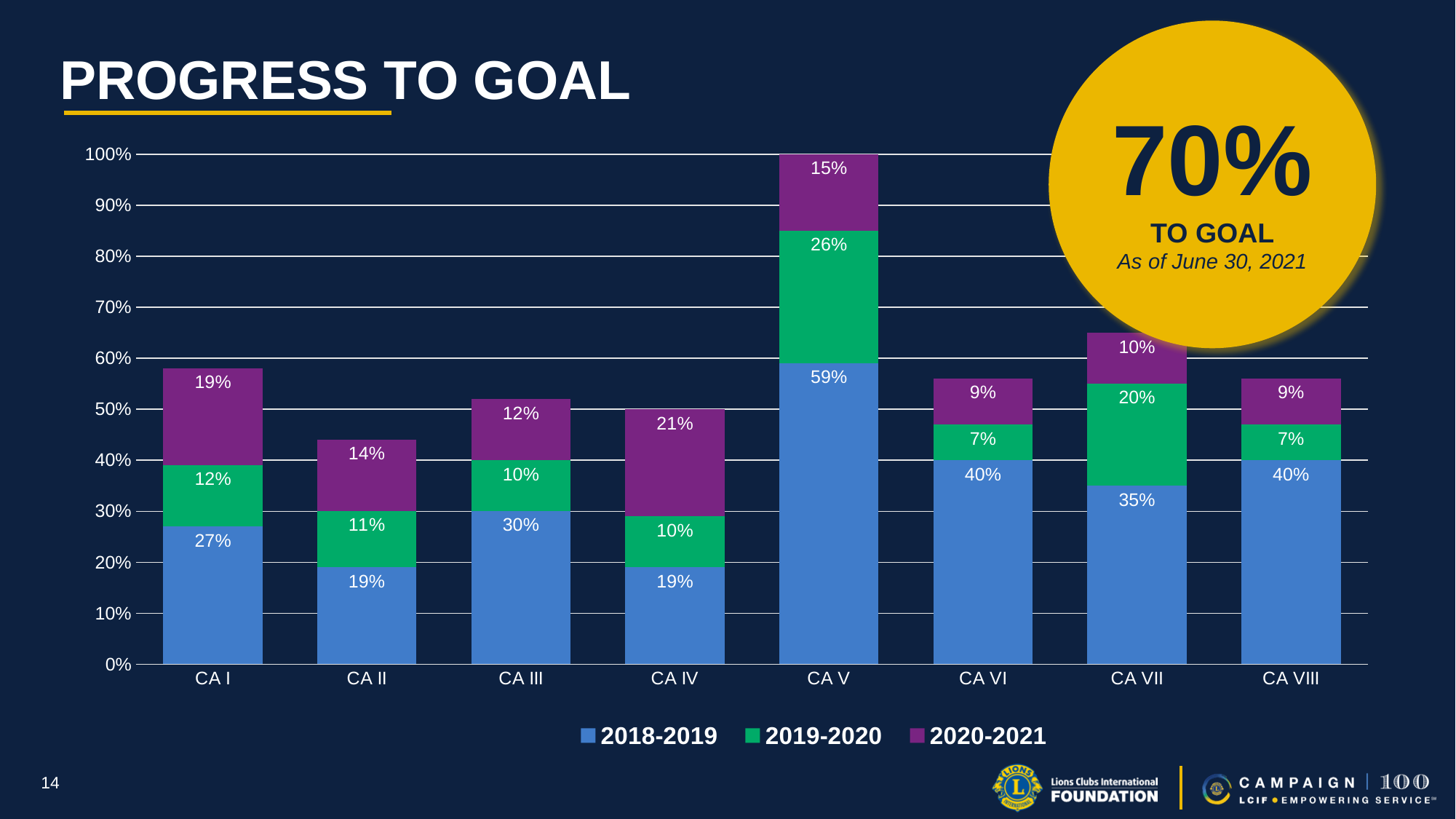
Which category has the highest 2018-2019 value? CA V What is the 2019-2020 value for CA VII? 20% What is the 2020-2021 value for CA IV? 21% What is the title of the chart? PROGRESS TO GOAL What is the total of the stacked bar for CA II? 44% What kind of chart is shown on the slide? Stacked bar chart Which category has the lowest 2020-2021 value? CA VI and CA VIII (9%) How many series does the legend list? 3 What is the 2018-2019 value for CA V? 59% Which is larger, the 2020-2021 value for CA I or for CA III? CA I How many categories are shown on the x axis? 8 What is the difference between the 2018-2019 values for CA V and CA VII? 24%